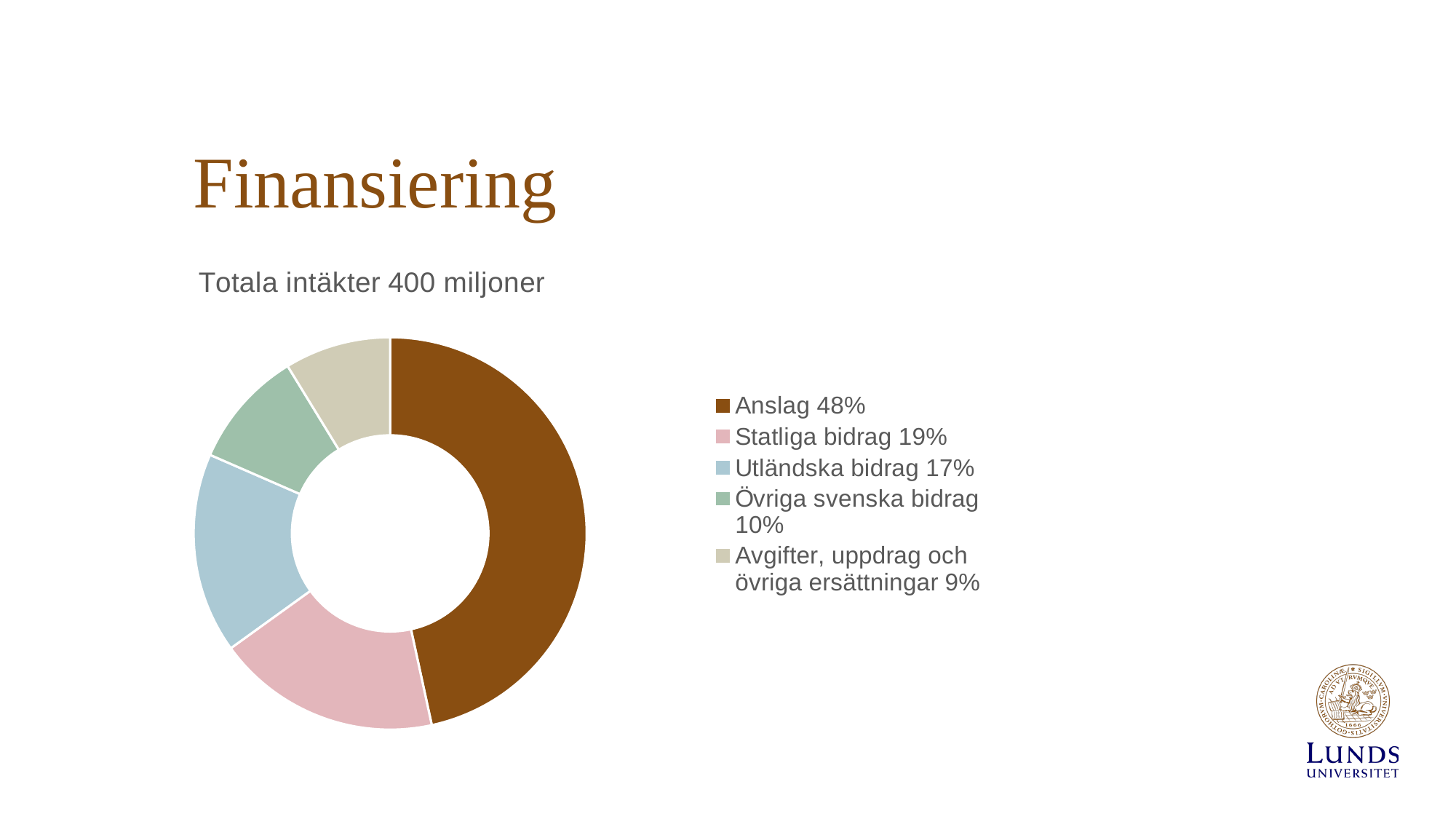
Which category has the smallest share of the chart? Avgifter, uppdrag och övriga ersättningar What share of the chart does Utländska bidrag represent? 17% Which category has the largest share of the chart? Anslag What share of the chart does Anslag represent? 48% What share of the chart does Avgifter, uppdrag och övriga ersättningar represent? 9% What total revenue is stated above the chart? Totala intäkter 400 miljoner What kind of chart is shown on the slide? Doughnut (pie) chart How many categories does the chart show? 5 Which is larger, Utländska bidrag or Övriga svenska bidrag? Utländska bidrag What is the difference in percentage points between Anslag and Statliga bidrag? 29 percentage points